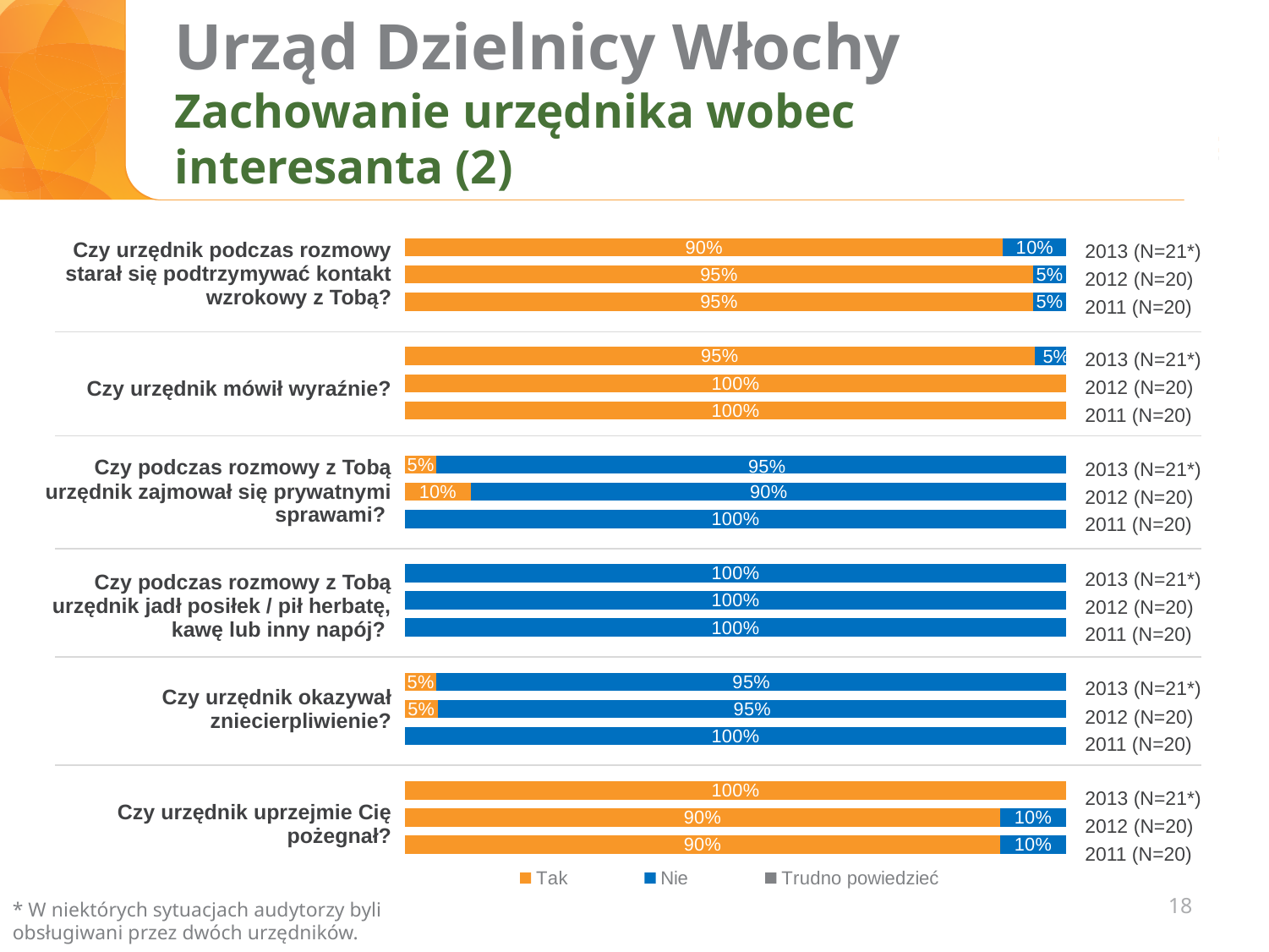
For the question "Czy urzędnik podczas rozmowy starał się podtrzymywać kontakt wzrokowy z Tobą?", did the Tak share rise or fall from 2011 to 2013? Fall For the question "Czy urzędnik podczas rozmowy starał się podtrzymywać kontakt wzrokowy z Tobą?", what is the difference between the Tak value for 2012 and the Tak value for 2013? 5 percentage points For the question "Czy urzędnik mówił wyraźnie?", what is the Tak value for 2012 (N=20)? 100% For the question "Czy urzędnik uprzejmie Cię pożegnał?", what is the Nie value for 2011 (N=20)? 10% For the question "Czy urzędnik podczas rozmowy starał się podtrzymywać kontakt wzrokowy z Tobą?", what is the Tak value for 2013 (N=21*)? 90% For the question "Czy urzędnik mówił wyraźnie?", what is the Nie value for 2013 (N=21*)? 5% What are the entries in the chart legend? Tak, Nie, Trudno powiedzieć For the question "Czy podczas rozmowy z Tobą urzędnik zajmował się prywatnymi sprawami?", what is the Nie value for 2012 (N=20)? 90% How many series does the legend list? 3 For the question "Czy urzędnik okazywał zniecierpliwienie?" in 2013 (N=21*), which is larger, Tak or Nie? Nie For the question "Czy urzędnik podczas rozmowy starał się podtrzymywać kontakt wzrokowy z Tobą?", what is the total of the 2013 (N=21*) bar? 100% What kind of chart is shown on the slide? Stacked bar chart